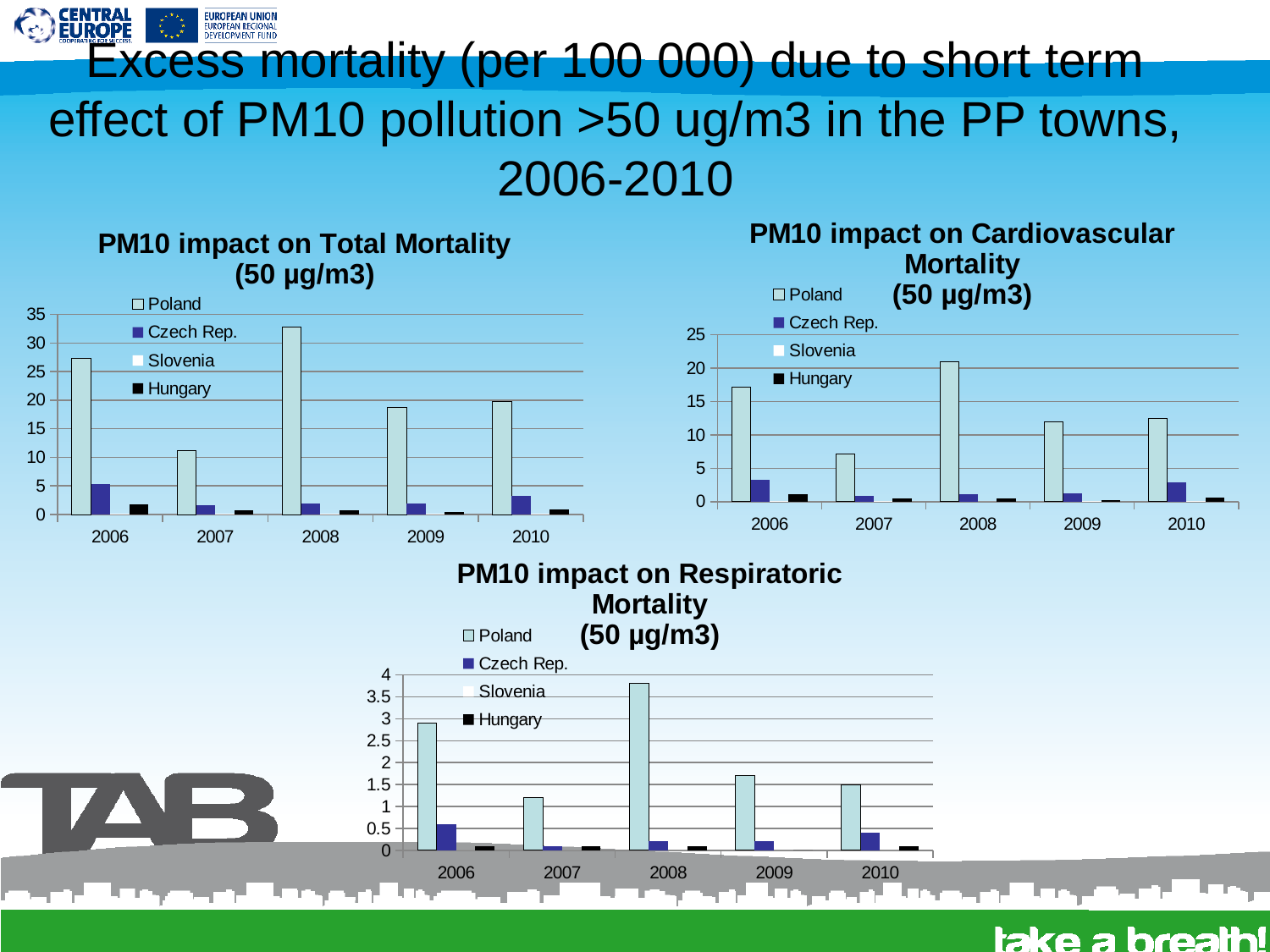
In the 'PM10 impact on Cardiovascular Mortality (50 µg/m3)' chart, in which year is the Poland value highest? 2008 In the 'PM10 impact on Total Mortality (50 µg/m3)' chart, which year has the larger Poland value, 2006 or 2007? 2006 How many years are shown on the x axis of the 'PM10 impact on Cardiovascular Mortality (50 µg/m3)' chart? 5 In the 'PM10 impact on Respiratoric Mortality (50 µg/m3)' chart, is the Poland value for 2008 greater or less than 3.5? greater In the 'PM10 impact on Respiratoric Mortality (50 µg/m3)' chart, is the Poland value for 2007 greater or less than 1.5? less How many series does the legend of the 'PM10 impact on Total Mortality (50 µg/m3)' chart list? 4 In the 'PM10 impact on Total Mortality (50 µg/m3)' chart, in which year is the Poland value lowest? 2007 Which country is listed first in the legend of the 'PM10 impact on Respiratoric Mortality (50 µg/m3)' chart? Poland In the 'PM10 impact on Total Mortality (50 µg/m3)' chart, is the Poland value for 2008 greater or less than 30? greater What kind of chart is the 'PM10 impact on Total Mortality (50 µg/m3)' chart? bar chart In the 'PM10 impact on Total Mortality (50 µg/m3)' chart, in which year is the Poland value highest? 2008